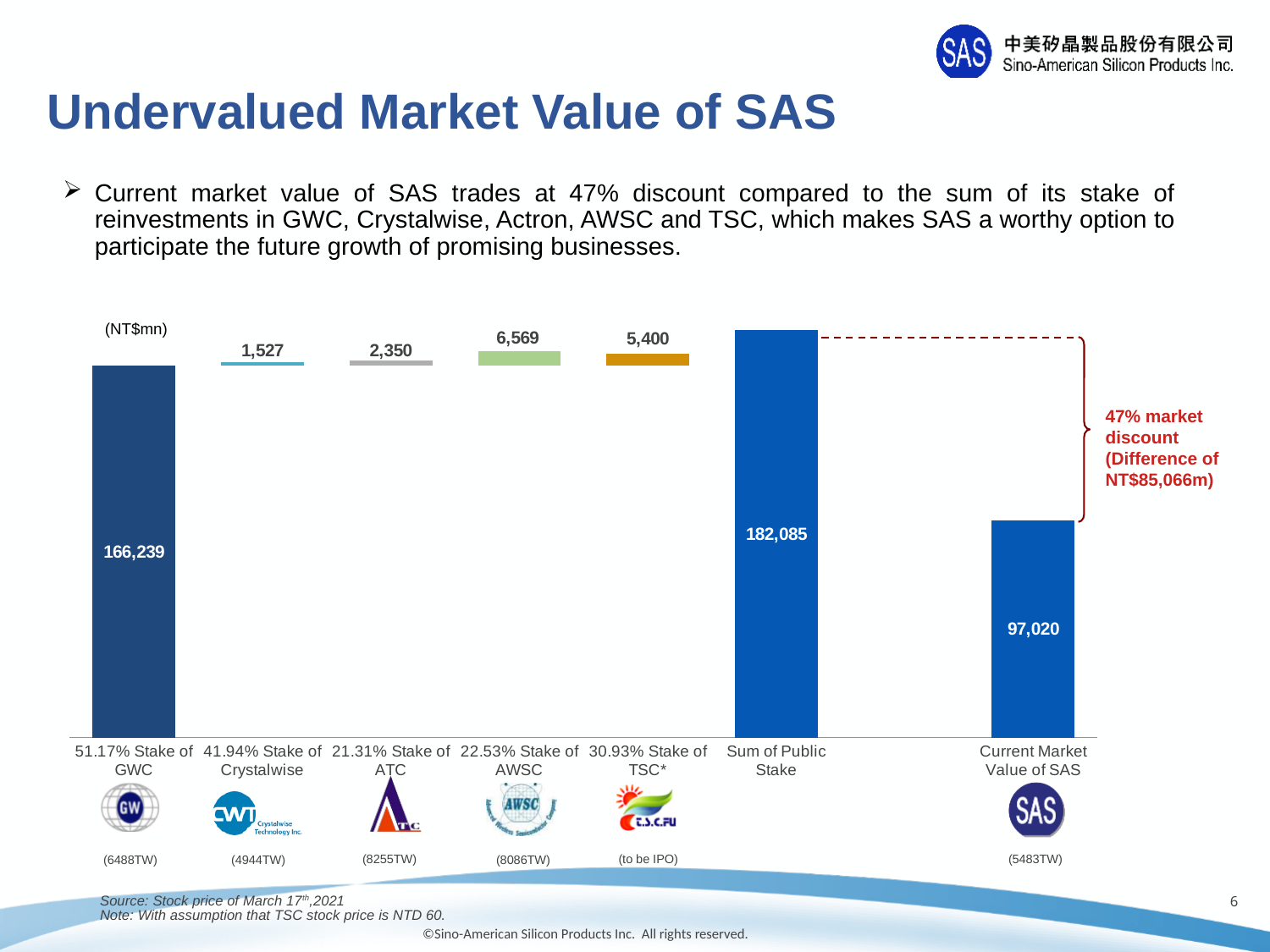
How many bars are plotted on the chart? 7 What is the difference between the Sum of Public Stake and the Current Market Value of SAS? 85,066 What is the Current Market Value of SAS shown on the chart? 97,020 What is the value for the 41.94% stake of Crystalwise? 1,527 What is the value for the 51.17% stake of GWC? 166,239 What is the value shown for the Sum of Public Stake? 182,085 What is the value for the 22.53% stake of AWSC? 6,569 What unit is indicated for the values on the chart? NT$mn What is the difference between the values for the ATC stake and the Crystalwise stake? 823 Which of the five individual stakes (GWC, Crystalwise, ATC, AWSC, TSC) has the lowest value? 41.94% Stake of Crystalwise Which is larger, the value for the 30.93% stake of TSC or the value for the 22.53% stake of AWSC? 22.53% Stake of AWSC Which of the five individual stakes (GWC, Crystalwise, ATC, AWSC, TSC) has the highest value? 51.17% Stake of GWC